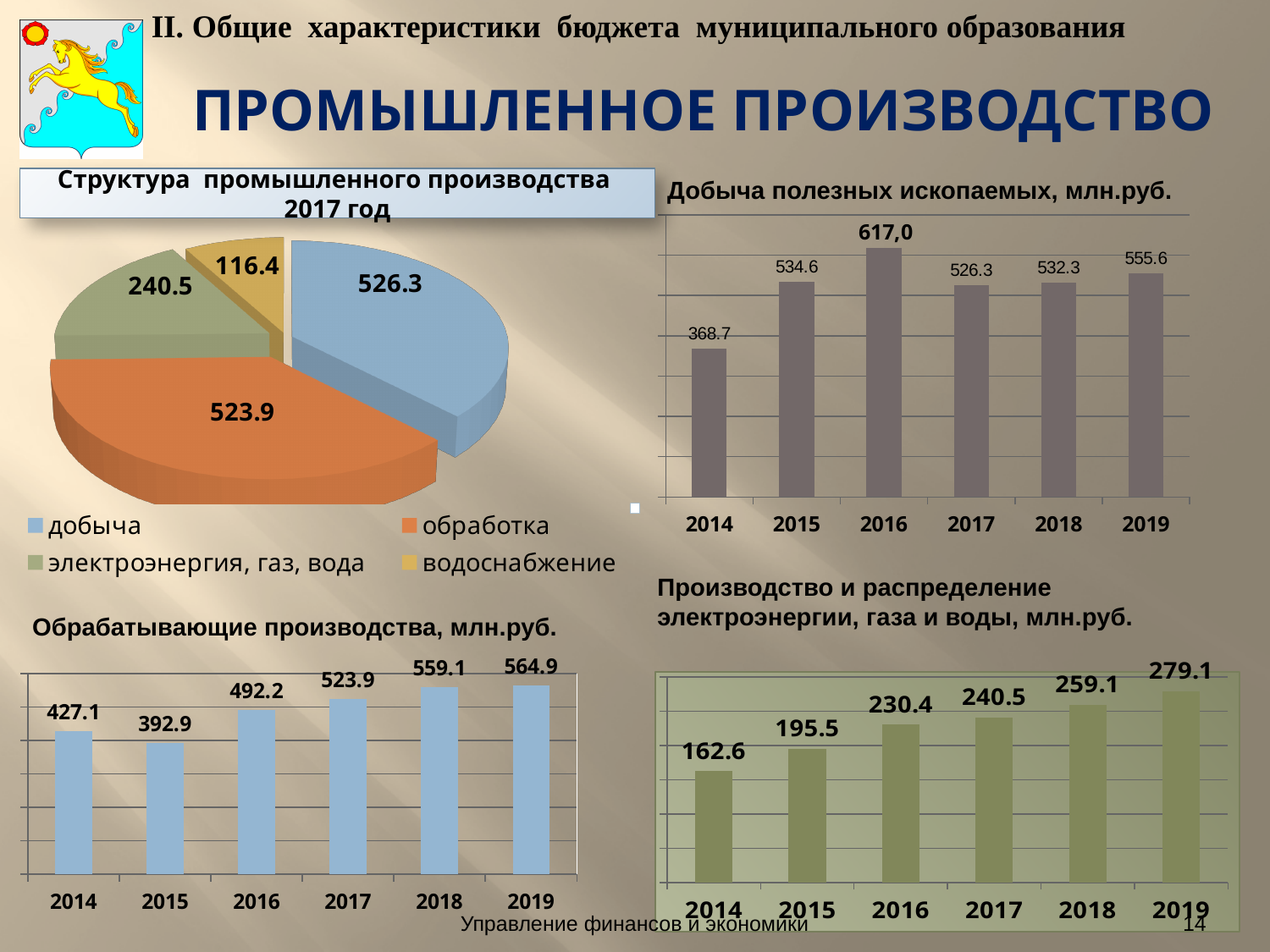
In the pie chart 'Структура промышленного производства 2017 год', which category has the smallest value? водоснабжение How many categories does the legend of the pie chart 'Структура промышленного производства 2017 год' list? 4 In the chart 'Обрабатывающие производства, млн.руб.', which year has the highest value? 2019 In the chart 'Добыча полезных ископаемых, млн.руб.', what is the difference between the 2016 and 2014 values? 248.3 In the chart 'Обрабатывающие производства, млн.руб.', what is the value for 2017? 523.9 In the chart 'Производство и распределение электроэнергии, газа и воды, млн.руб.', what is the difference between the 2019 and 2014 values? 116.5 In the chart 'Обрабатывающие производства, млн.руб.', which is larger: the value for 2014 or the value for 2015? 2014 In the chart 'Добыча полезных ископаемых, млн.руб.', what is the value for 2016? 617,0 What kind of chart is 'Добыча полезных ископаемых, млн.руб.'? bar chart In the chart 'Добыча полезных ископаемых, млн.руб.', which year has the lowest value? 2014 In the pie chart 'Структура промышленного производства 2017 год', what is the value for обработка? 523.9 In the chart 'Производство и распределение электроэнергии, газа и воды, млн.руб.', do the values rise or fall from 2014 to 2019? rise